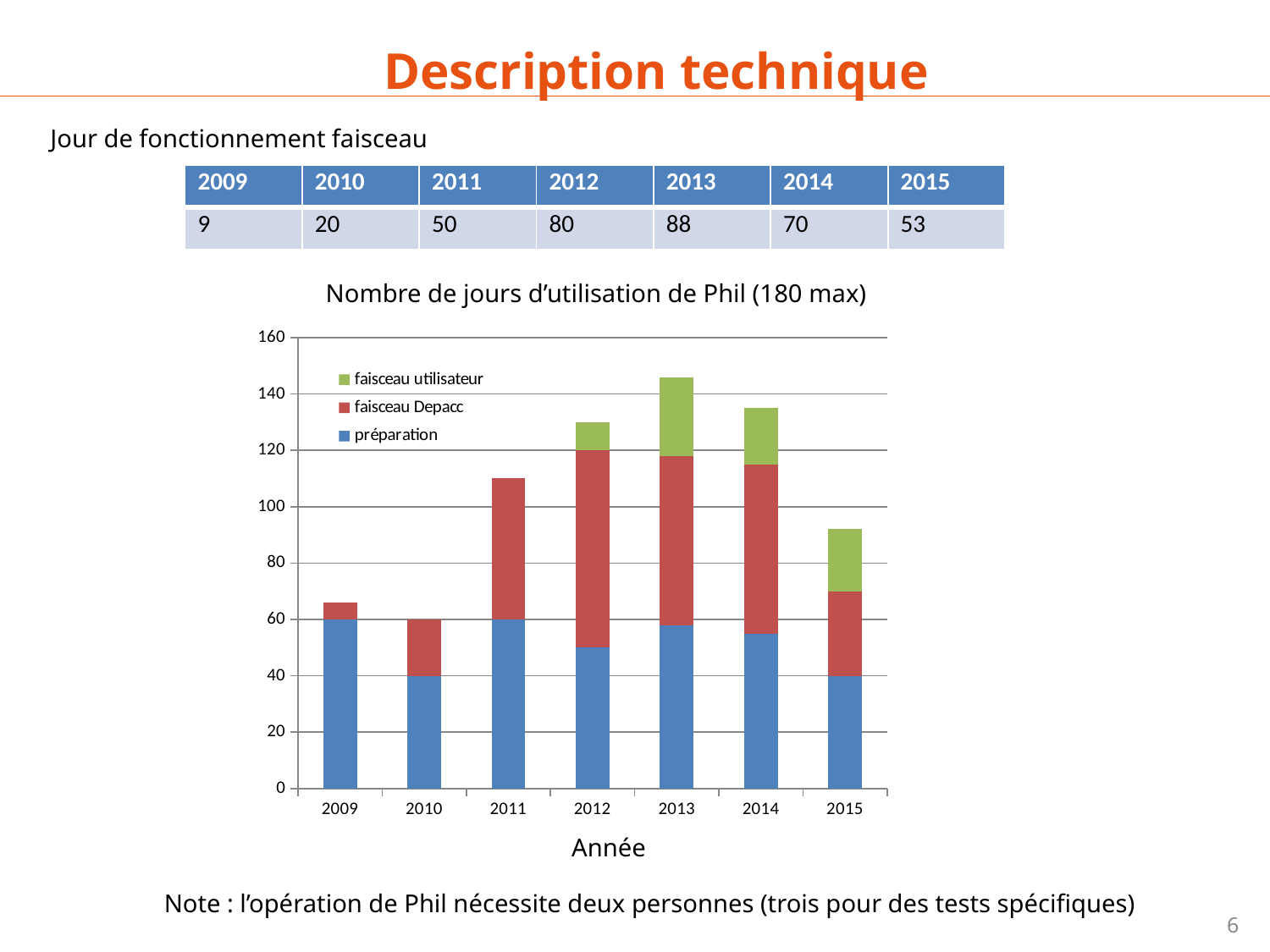
What kind of chart is shown on the slide? bar chart Which year has the tallest stacked bar in the chart? 2013 Which year has the taller stacked bar, 2011 or 2015? 2011 How many series does the chart legend list? 3 Is the total stacked bar for 2015 greater or less than 100? less Which year has the shortest stacked bar in the chart? 2010 Is the total stacked bar for 2012 greater or less than 120? greater Is the total stacked bar for 2013 greater or less than 140? greater What is the title of the chart? Nombre de jours d'utilisation de Phil (180 max) In which year does the faisceau utilisateur series first appear in the chart? 2012 Do the total stacked bar heights rise or fall from 2009 to 2013? rise How many years are shown on the x axis of the chart? 7